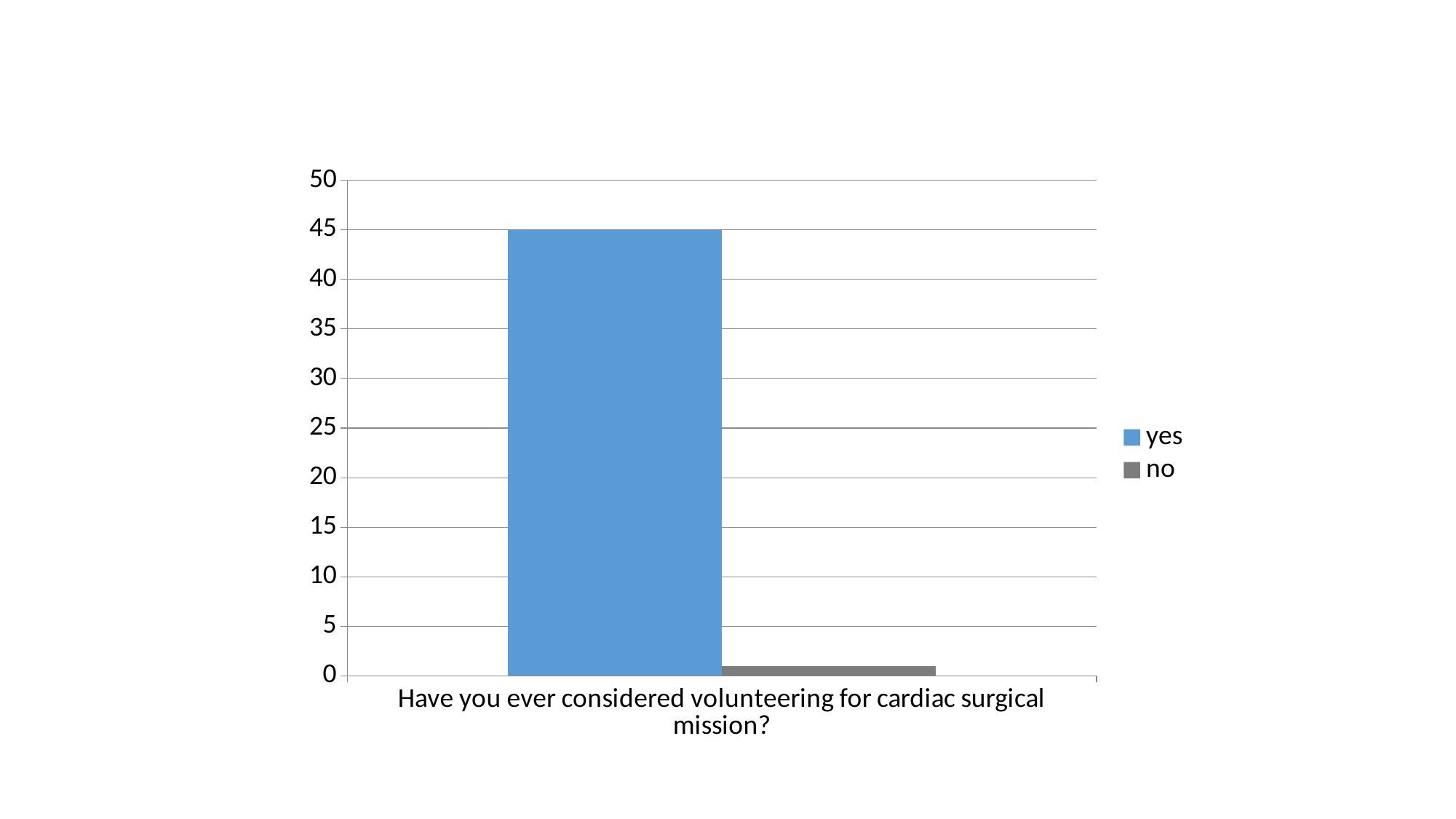
What kind of chart is shown on the slide? bar chart What are the entries listed in the legend? yes, no Which series has the highest value? yes Which is larger, the value for "yes" or the value for "no"? yes What is the category label shown on the x axis? Have you ever considered volunteering for cardiac surgical mission? Which series has the lowest value? no Is the value for "no" greater or less than 5? less Is the value for "yes" greater or less than 40? greater What is the value for "yes"? 45 How many categories are shown on the x axis? 1 How many series does the legend list? 2